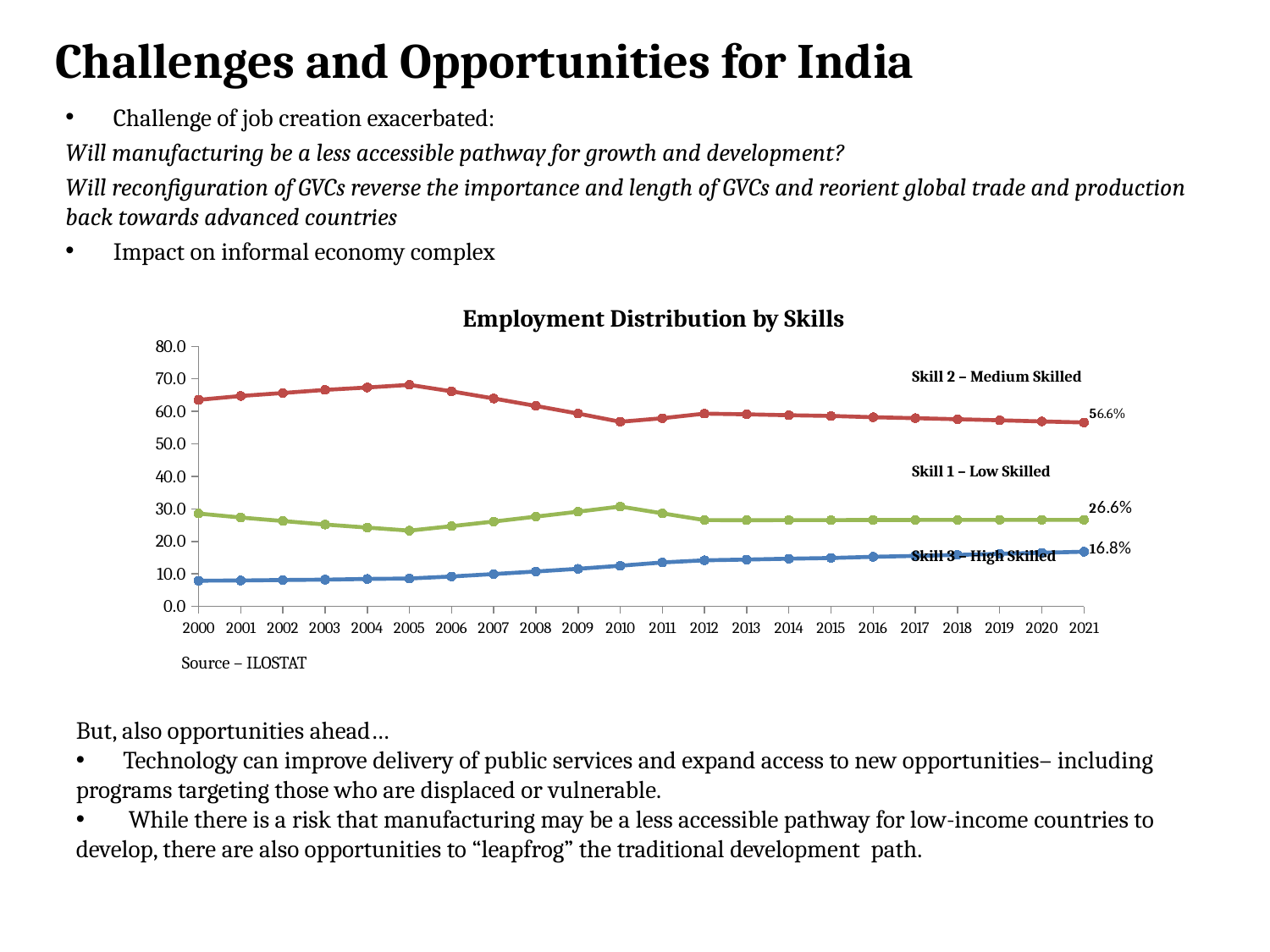
How many years are shown on the x axis of the "Employment Distribution by Skills" chart? 22 In the "Employment Distribution by Skills" chart, is the value for Skill 2 – Medium Skilled in 2005 greater or less than 60.0? greater In the "Employment Distribution by Skills" chart, which skill series has the highest value in 2021? Skill 2 – Medium Skilled In the "Employment Distribution by Skills" chart, what is the difference between the 2021 values for Skill 2 – Medium Skilled and Skill 1 – Low Skilled? 30.0% In the "Employment Distribution by Skills" chart, what is the difference between the 2021 values for Skill 1 – Low Skilled and Skill 3 – High Skilled? 9.8% In the "Employment Distribution by Skills" chart, what is the value for Skill 1 – Low Skilled in 2021? 26.6% In the "Employment Distribution by Skills" chart, what is the value for Skill 2 – Medium Skilled in 2021? 56.6% In the "Employment Distribution by Skills" chart, what is the value for Skill 3 – High Skilled in 2021? 16.8% What type of chart is "Employment Distribution by Skills"? line chart In the "Employment Distribution by Skills" chart, does the Skill 3 – High Skilled line rise or fall from 2000 to 2021? rise In the "Employment Distribution by Skills" chart, which skill series has the lowest value in 2021? Skill 3 – High Skilled How many skill series are plotted in the "Employment Distribution by Skills" chart? 3